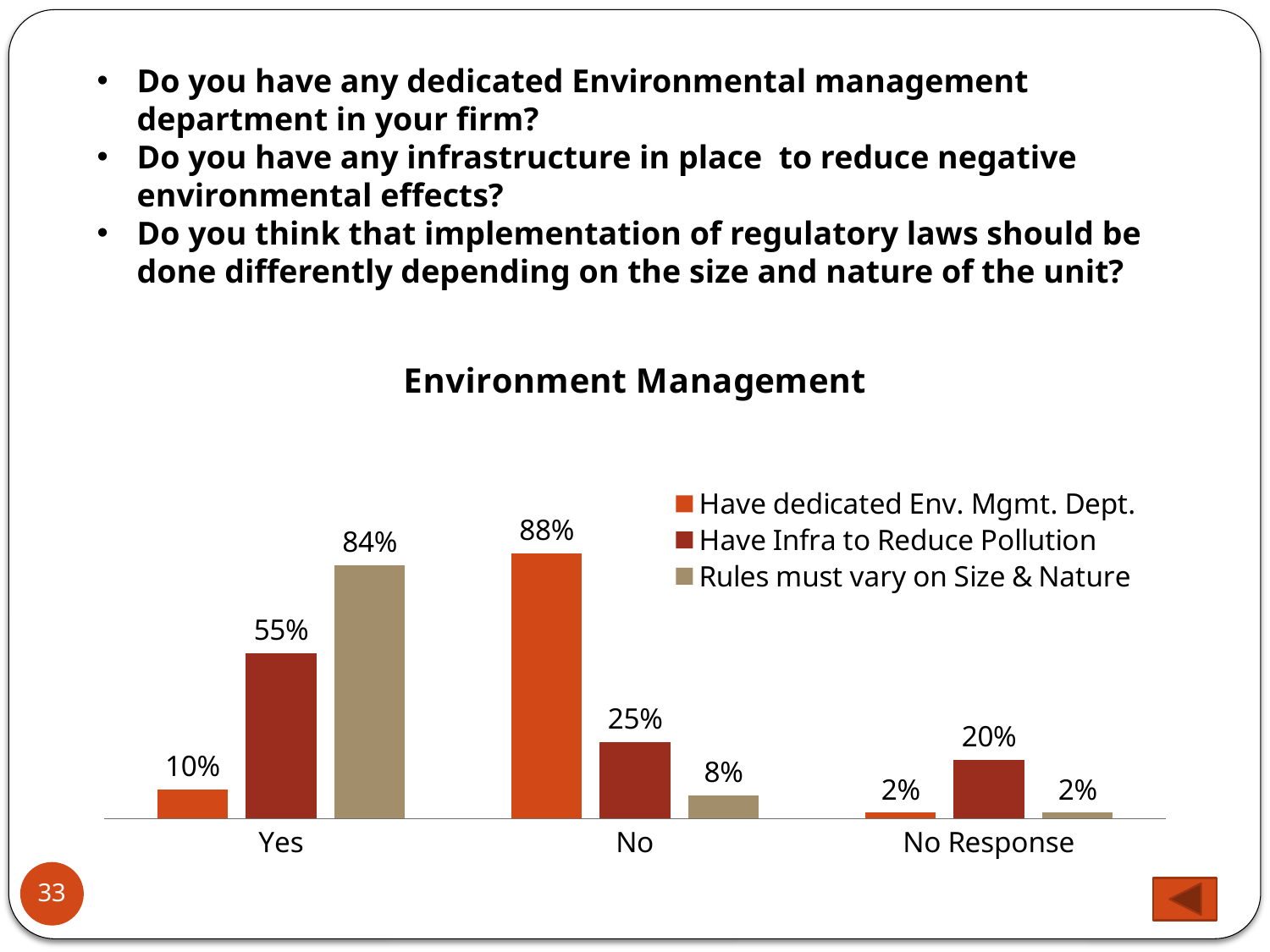
How many series does the legend list? 3 In the No category, which is larger: 'Have dedicated Env. Mgmt. Dept.' or 'Have Infra to Reduce Pollution'? Have dedicated Env. Mgmt. Dept. Which series is shown in orange in the legend? Have dedicated Env. Mgmt. Dept. Which category has the highest value for 'Have dedicated Env. Mgmt. Dept.'? No What is the value for 'Have Infra to Reduce Pollution' in the No Response category? 20% How many categories are shown on the x axis? 3 Which category has the lowest value for 'Rules must vary on Size & Nature'? No Response What is the title of the chart? Environment Management What is the difference between the Yes and No values for 'Have Infra to Reduce Pollution'? 30% What kind of chart is shown on the slide? Bar chart What is the value for 'Rules must vary on Size & Nature' in the Yes category? 84% What percentage of respondents answered Yes to having a dedicated Env. Mgmt. Dept.? 10%